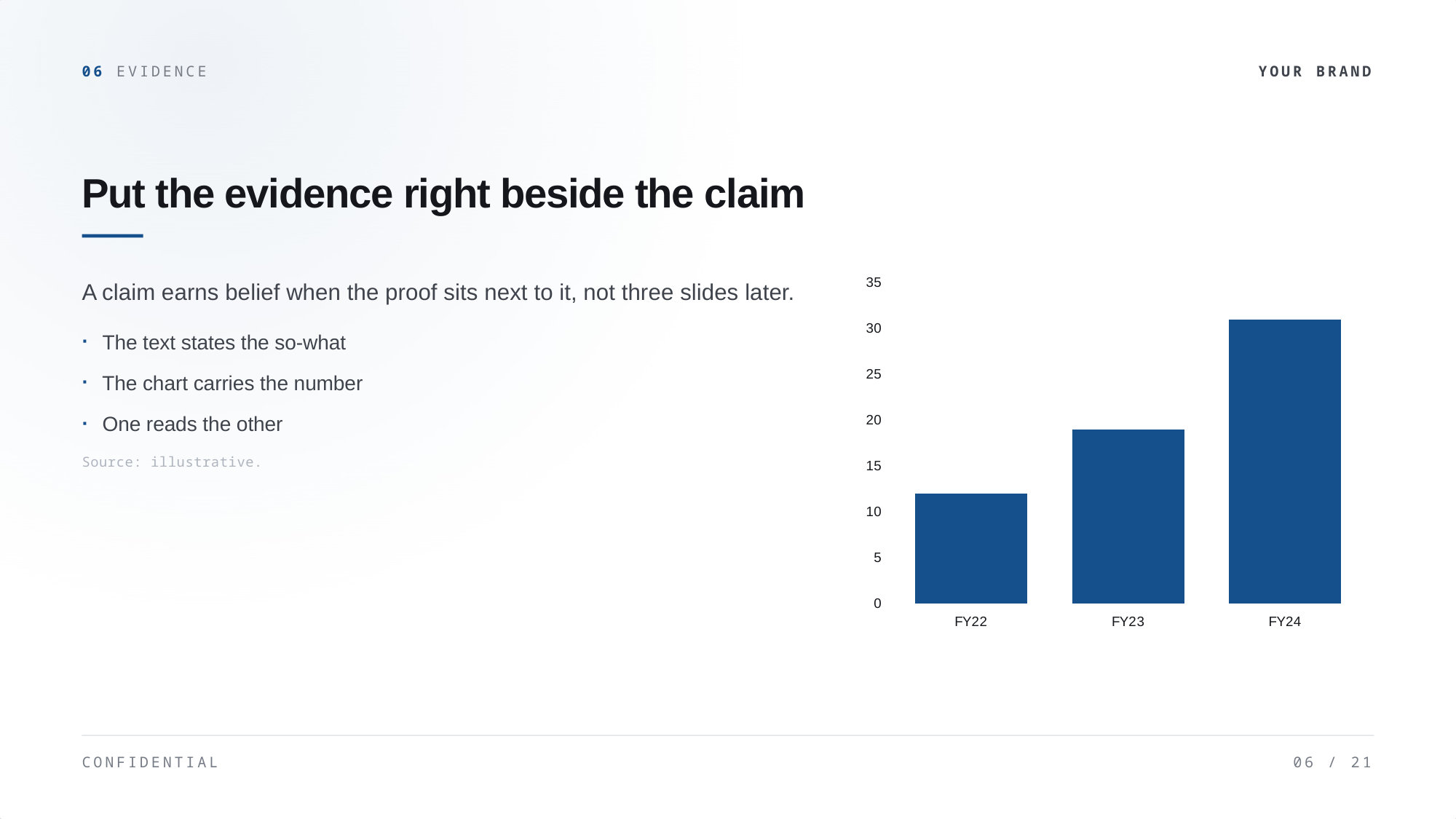
Is the value for FY24 greater or less than 35? less Is the value for FY22 greater or less than 10? greater Is the value for FY24 greater or less than 25? greater Which category has the highest bar? FY24 What kind of chart is shown on the slide? bar chart Do the values rise or fall from FY22 to FY24? rise What is the highest value shown on the vertical axis? 35 How many bars does the chart show? 3 Which is larger, the value for FY23 or the value for FY22? FY23 Which category has the lowest bar? FY22